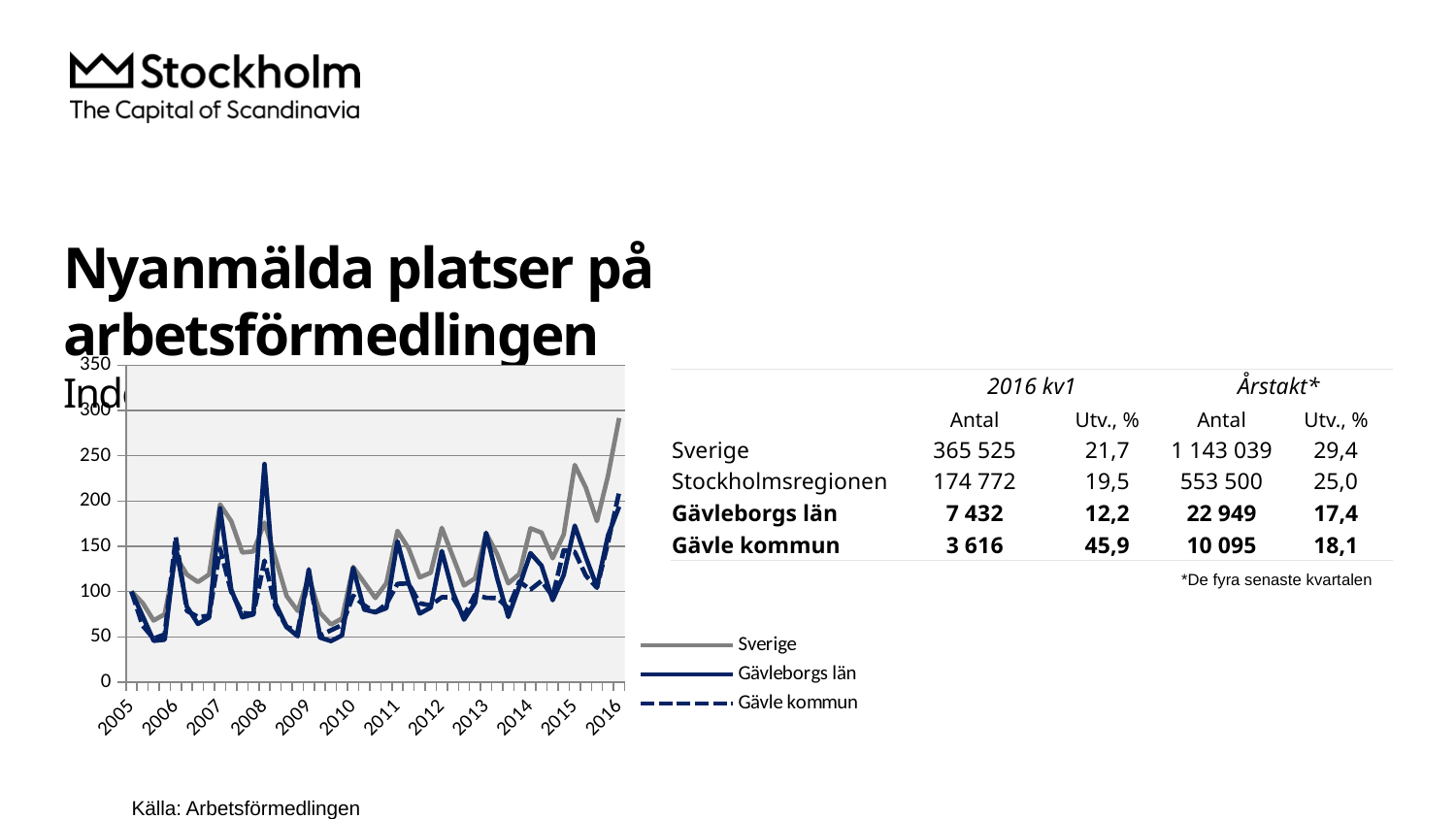
How many series does the chart legend list? 3 At 2016, is the value for Gävleborgs län greater or less than 150? greater At 2016, is the value for Sverige greater or less than 250? greater Is the peak value for Gävleborgs län around 2008 greater or less than 200? greater Does the Sverige series rise or fall between 2015 and 2016? rise At 2016, which is larger: the value for Sverige or the value for Gävleborgs län? Sverige How many year labels are shown on the x axis of the chart? 12 Which series in the chart is drawn in grey? Sverige Which series has the highest value at the end of the chart (2016)? Sverige Which series in the chart is drawn with a dashed line? Gävle kommun What kind of chart is shown on the slide? line chart